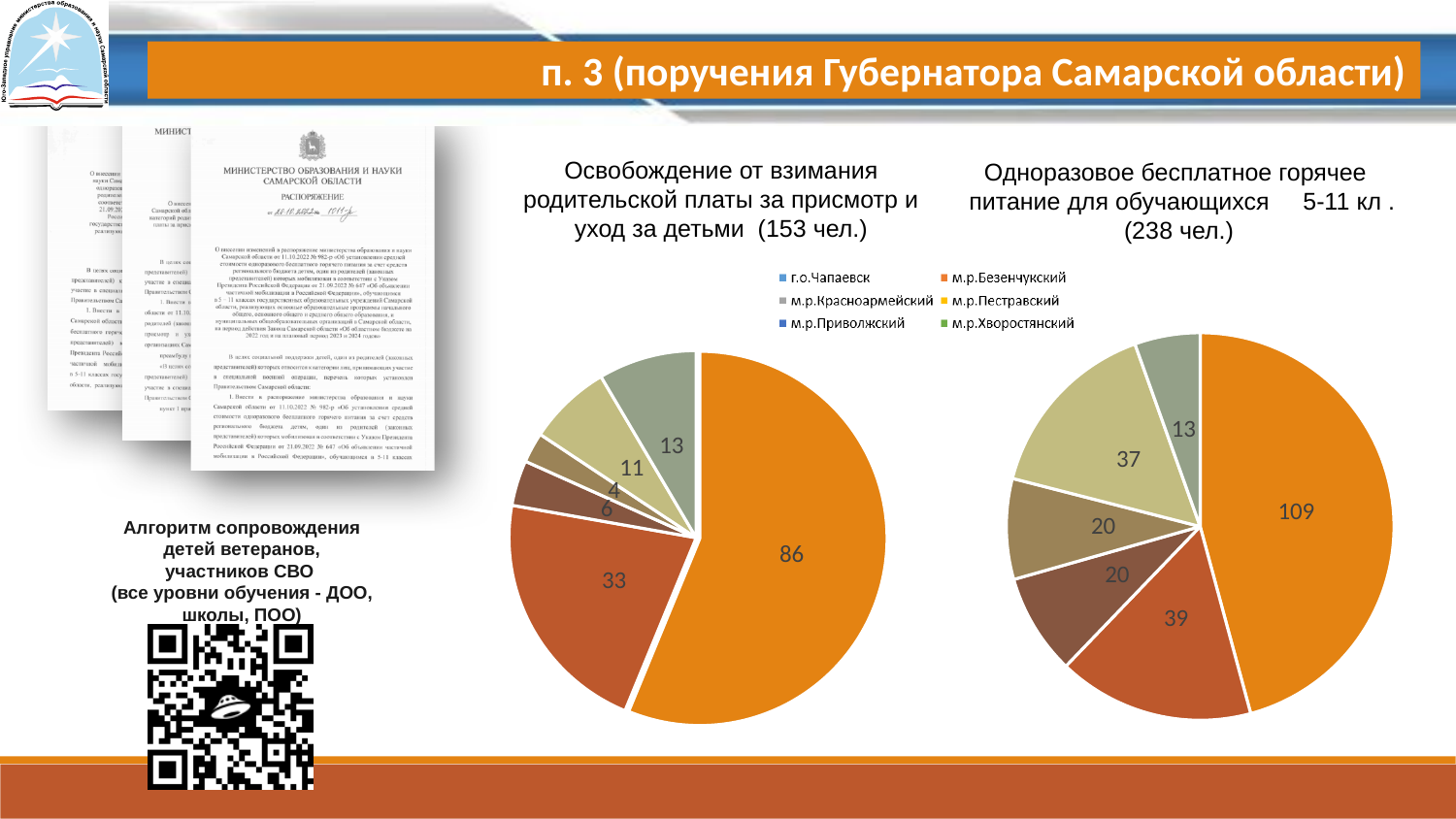
What type of chart is used for 'Освобождение от взимания родительской платы за присмотр и уход за детьми'? pie chart In the right pie chart (Одноразовое бесплатное горячее питание), what is the value of the smallest slice? 13 In the left pie chart (Освобождение от взимания родительской платы), what is the difference between the largest slice (86) and the second largest slice (33)? 53 According to its title, how many people in total does the right pie chart (Одноразовое бесплатное горячее питание) cover? 238 чел. Which chart has the larger biggest slice: the left pie chart (Освобождение от взимания родительской платы) or the right pie chart (Одноразовое бесплатное горячее питание)? the right pie chart (Одноразовое бесплатное горячее питание) In the left pie chart (Освобождение от взимания родительской платы), what is the value of the smallest slice? 4 How many entries does the legend shared by the two pie charts list? 6 In the right pie chart (Одноразовое бесплатное горячее питание), what is the difference between the largest slice (109) and the second largest slice (39)? 70 How many slices does the left pie chart (Освобождение от взимания родительской платы) have? 6 According to its title, how many people in total does the left pie chart (Освобождение от взимания родительской платы) cover? 153 чел. In the left pie chart (Освобождение от взимания родительской платы), what is the value of the largest slice? 86 In the right pie chart (Одноразовое бесплатное горячее питание), what is the value of the largest slice? 109